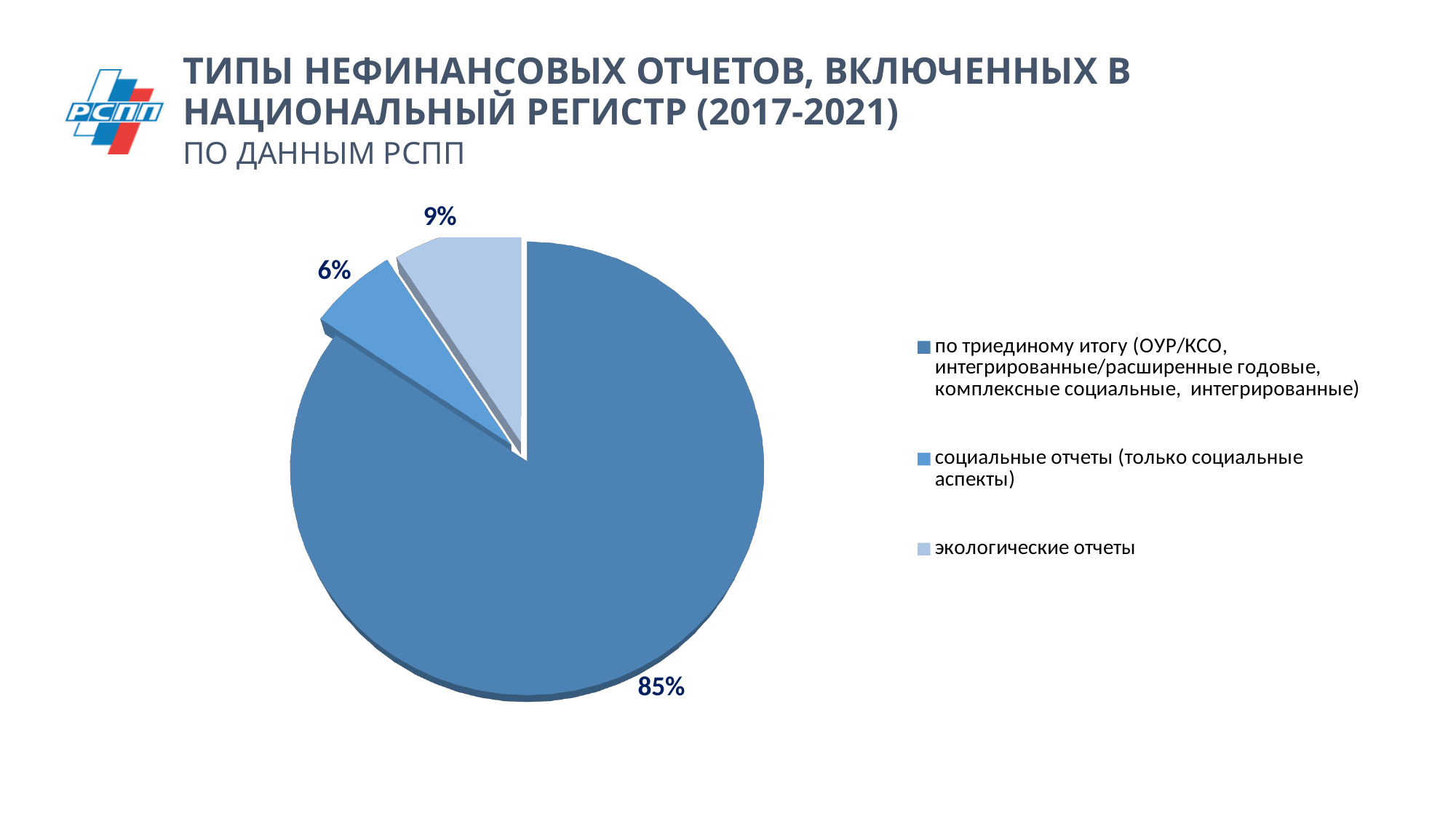
What is the title of the chart on the slide? ТИПЫ НЕФИНАНСОВЫХ ОТЧЕТОВ, ВКЛЮЧЕННЫХ В НАЦИОНАЛЬНЫЙ РЕГИСТР (2017-2021) What kind of chart is shown on the slide? pie chart Which slice is larger: экологические отчеты or социальные отчеты (только социальные аспекты)? экологические отчеты Which category has the largest slice of the pie? по триединому итогу (ОУР/КСО, интегрированные/расширенные годовые, комплексные социальные, интегрированные) How many slices does the pie chart have? 3 What share of the pie is labelled for социальные отчеты (только социальные аспекты)? 6% Which category has the smallest slice of the pie? социальные отчеты (только социальные аспекты) What share of the pie is labelled for экологические отчеты? 9% How many entries does the legend list? 3 What is the difference in percentage points between the экологические отчеты slice and the социальные отчеты slice? 3% What is the difference in percentage points between the largest slice and the экологические отчеты slice? 76% What share of the pie is labelled for the slice по триединому итогу (ОУР/КСО, интегрированные/расширенные годовые, комплексные социальные, интегрированные)? 85%